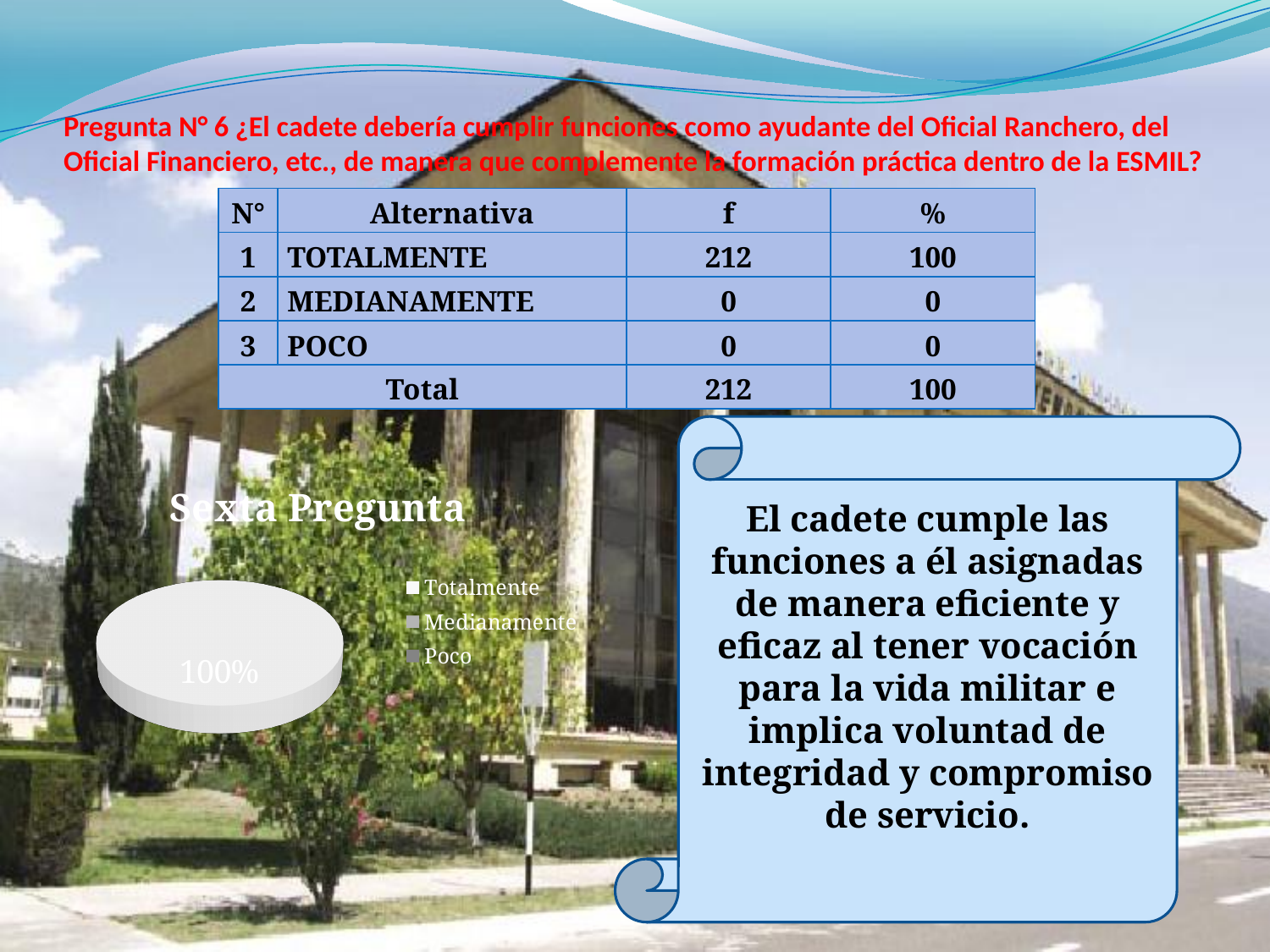
Which category has the largest slice of the pie? Totalmente What kind of chart is shown on the slide? pie chart How many entries does the chart's legend list? 3 Which legend entry is listed first in the chart's legend? Totalmente What share of the pie does the Totalmente slice take? 100% What is the title of the chart? Sexta Pregunta What percentage value is printed as a data label on the pie chart? 100% Is the share for Totalmente larger or smaller than the share for Poco? larger How many visible slices does the pie chart have? 1